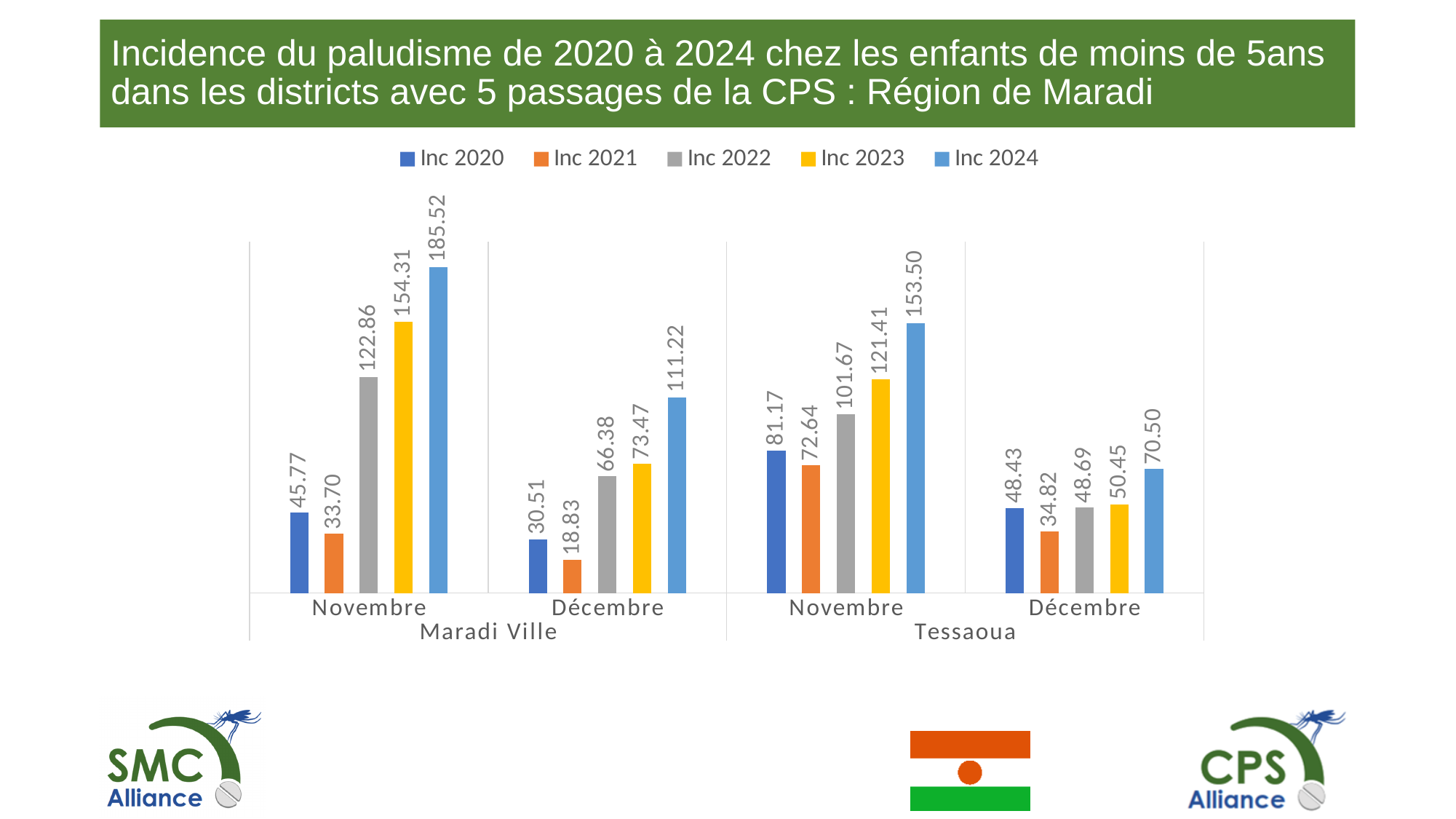
Which bar has the highest value on the chart? Inc 2024, Novembre, Maradi Ville (185.52) What kind of chart is shown on the slide? Bar chart Which bar has the lowest value on the chart? Inc 2021, Décembre, Maradi Ville (18.83) What is the difference between the Inc 2024 and Inc 2020 values for Novembre in Tessaoua? 72.33 For Décembre in Tessaoua, do the values rise or fall from Inc 2022 to Inc 2024? Rise How many category groups are shown on the x axis? 4 Which is larger: the Inc 2023 value for Décembre in Maradi Ville or the Inc 2023 value for Décembre in Tessaoua? Décembre in Maradi Ville What is the difference between the Inc 2024 and Inc 2023 values for Novembre in Maradi Ville? 31.21 What is the Inc 2022 value for Novembre in Tessaoua? 101.67 What is the Inc 2024 value for Novembre in Maradi Ville? 185.52 How many series does the legend list? 5 What is the Inc 2021 value for Décembre in Maradi Ville? 18.83